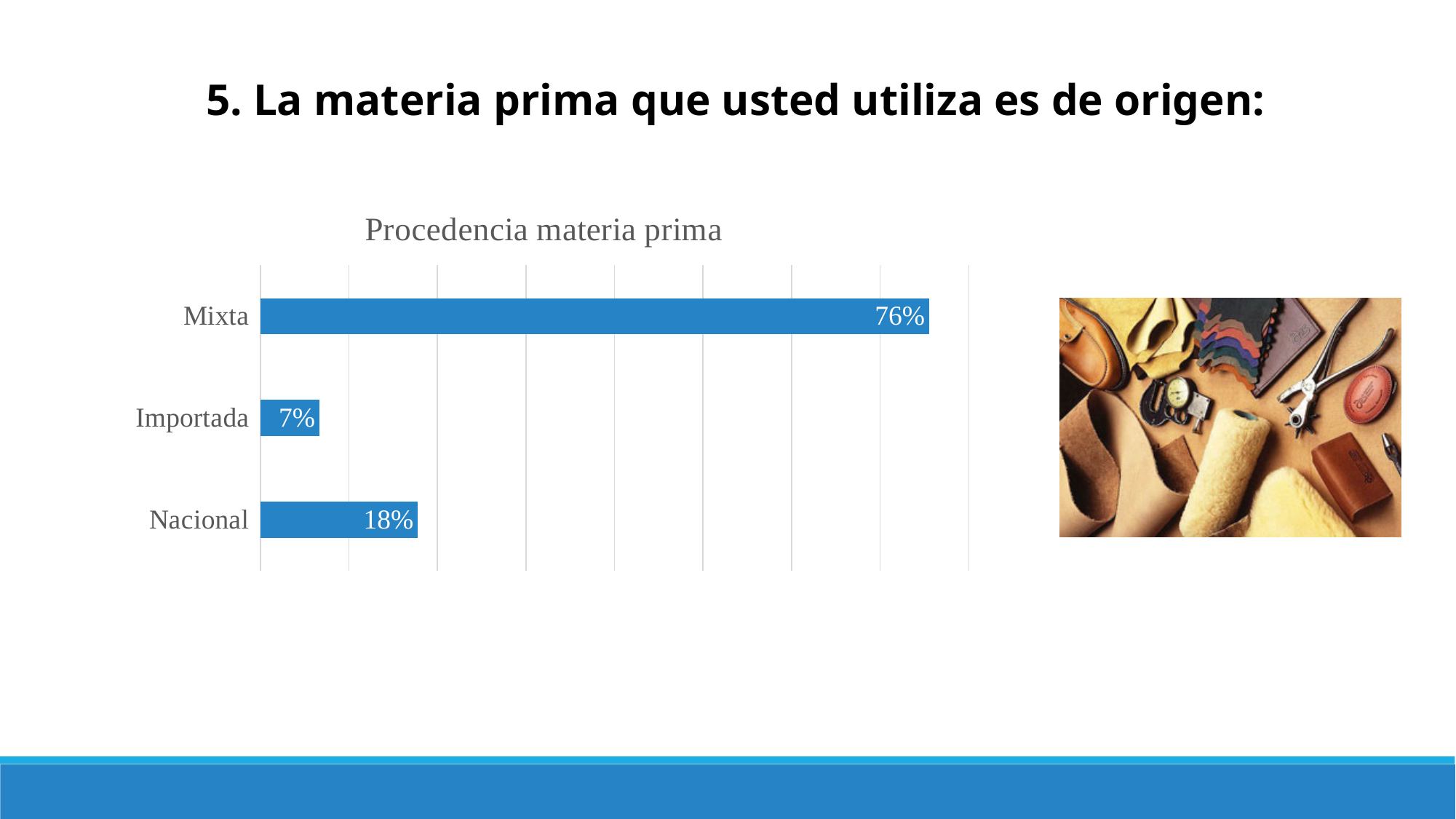
What colour are the bars in the chart? Blue Which category has the highest value? Mixta Which is larger, the value for Nacional or the value for Importada? Nacional What is the difference between the values for Nacional and Importada? 11% What is the value for Mixta? 76% What is the value for Importada? 7% What is the title of the chart? Procedencia materia prima What kind of chart is shown on the slide? Bar chart How many categories are shown in the chart? 3 What is the difference between the values for Mixta and Nacional? 58% What is the value for Nacional? 18% Which category has the lowest value? Importada